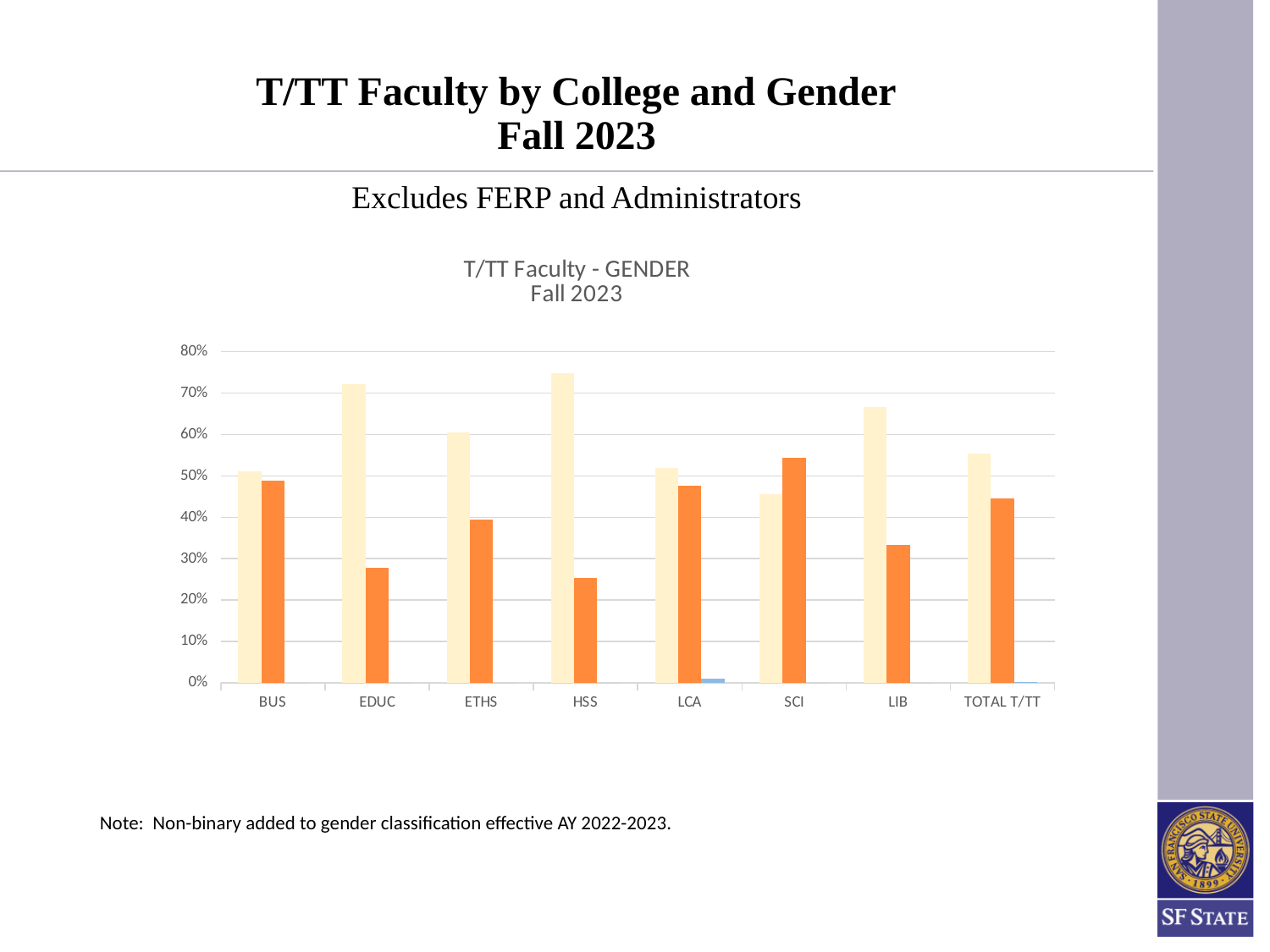
Is the orange bar for HSS greater or less than 30%? less For ETHS, which is larger, the light yellow bar or the orange bar? the light yellow bar Is the light yellow bar for LIB greater or less than 60%? greater For SCI, which is larger, the light yellow bar or the orange bar? the orange bar How many categories are shown along the x axis of the chart? 8 Which category has the shortest orange bar? HSS Which category has the tallest light yellow bar? HSS Which category has the tallest orange bar? SCI Which category has the shortest light yellow bar? SCI What kind of chart is shown on the slide? bar chart Is the light yellow bar for EDUC greater or less than 70%? greater What is the title of the chart? T/TT Faculty - GENDER Fall 2023